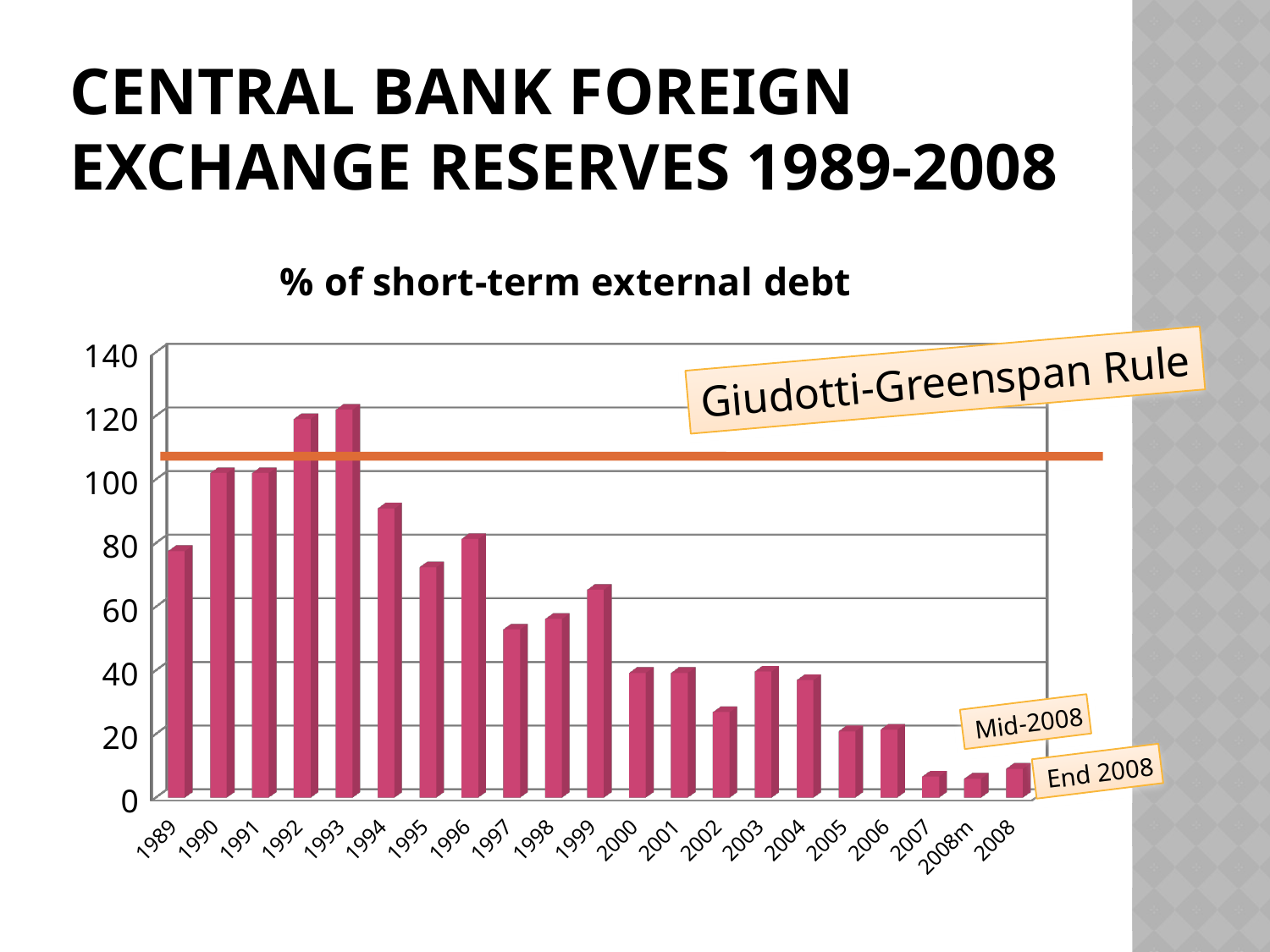
Do the values generally rise or fall from 1993 to 2008? fall Which is larger, the value for 1996 or the value for 1997? 1996 Is the value for 1994 greater or less than 80? greater Is the value for 1989 greater or less than 60? greater Is the value for 1997 greater or less than 60? less Which is larger, the value for 1990 or the value for 1994? 1990 How many bars (categories) are plotted on the x axis? 21 What is the horizontal orange line on the chart labelled? Giudotti-Greenspan Rule What is the title of the chart? % of short-term external debt What kind of chart is shown on the slide? bar chart